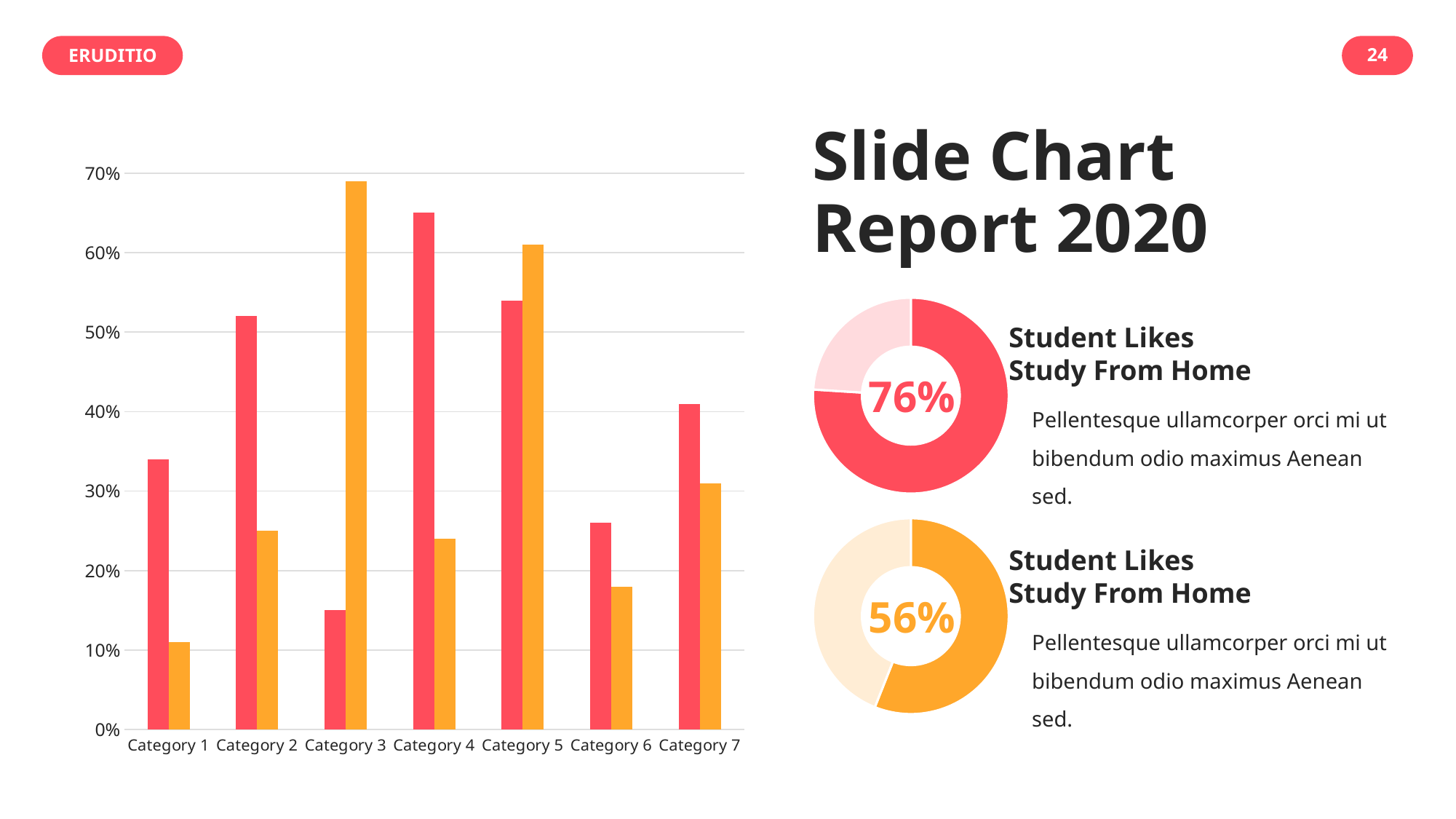
In the bar chart on the left, is the orange bar for Category 6 greater or less than 20%? less In the bar chart on the left, which category has the shortest orange bar? Category 1 In the bar chart on the left, what kind of chart is it? bar chart In the bar chart on the left, for Category 2, which bar is taller, the red one or the orange one? the red one In the bottom donut chart on the right, what percentage is shown in the centre? 56% In the bar chart on the left, which category has the shortest red bar? Category 3 In the bar chart on the left, is the orange bar for Category 3 greater or less than 60%? greater In the bar chart on the left, is the red bar for Category 1 greater or less than 30%? greater In the bar chart on the left, which category has the tallest orange bar? Category 3 In the top donut chart on the right, what percentage is shown in the centre? 76% In the bar chart on the left, which category has the tallest red bar? Category 4 In the bar chart on the left, how many categories are shown on the x axis? 7